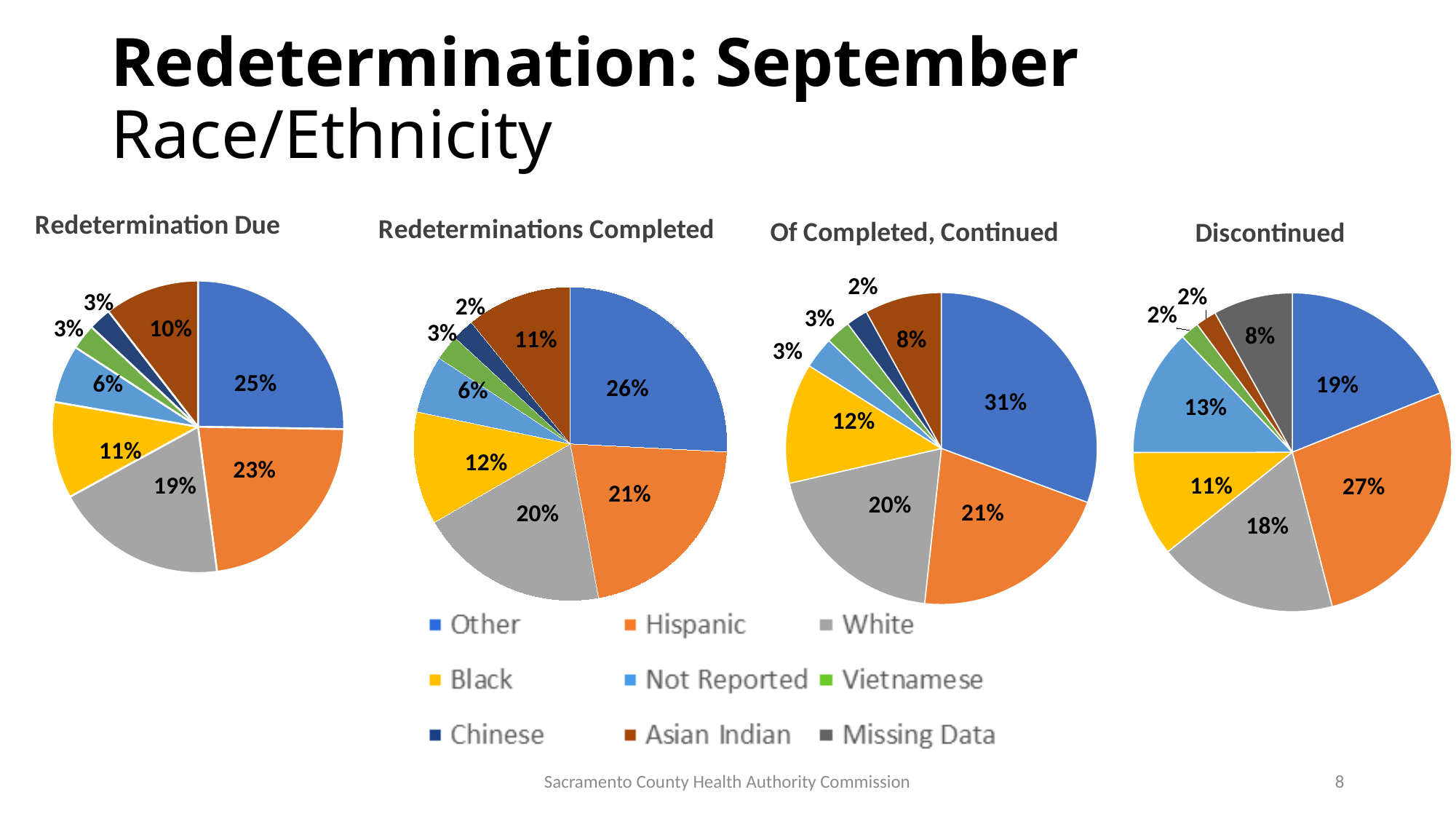
In the Discontinued chart, which category has the largest slice? Hispanic In the Of Completed, Continued chart, what percentage is shown for the Asian Indian slice? 8% What type of chart is used on this slide? Pie chart In the Discontinued chart, what percentage is shown for the Not Reported slice? 13% What is the title of the chart on the far right of the slide? Discontinued How many categories does the legend list? 9 In the Of Completed, Continued chart, which category has the largest slice? Other In the Redeterminations Completed chart, which is larger, the Black slice or the Asian Indian slice? Black In the Discontinued chart, which is larger, the Other slice or the White slice? Other In the Redeterminations Completed chart, what percentage is shown for the White slice? 20% In the Redetermination Due chart, what is the difference between the Hispanic and White shares? 4% In the Redetermination Due chart, what share is labelled for the Other slice? 25%